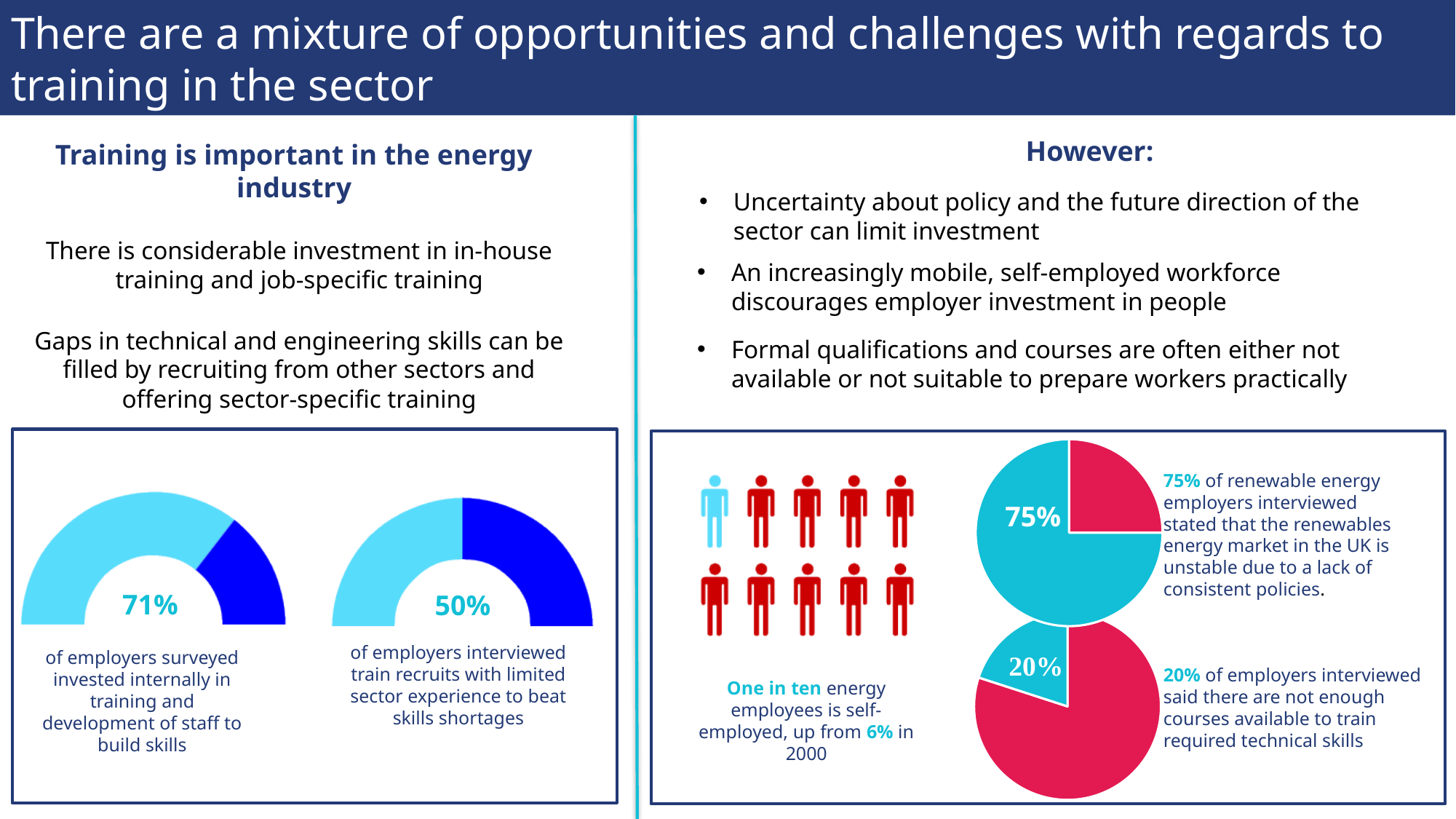
In the upper pie chart on the right of the slide, what share of renewable energy employers interviewed stated that the UK renewables market is unstable due to a lack of consistent policies? 75% According to the pictogram text in the bottom-right panel, what was the share of self-employed energy employees in 2000? 6% How many person icons are shown in the pictogram in the bottom-right panel? 10 On the right-hand gauge chart in the bottom-left panel, what percentage of employers interviewed train recruits with limited sector experience to beat skills shortages? 50% In the lower pie chart on the right of the slide, what percentage of employers interviewed said there are not enough courses are available to train required technical skills? 20% According to the pictogram in the bottom-right panel, what proportion of energy employees is self-employed? One in ten What is the difference between the 71% and 50% values shown on the two gauge charts in the bottom-left panel? 21 percentage points What is the difference between the 75% shown in the upper pie chart and the 20% shown in the lower pie chart on the right of the slide? 55 percentage points Which of the two gauge charts in the bottom-left panel shows the larger value: the one about investing internally in training or the one about training recruits with limited sector experience? Investing internally in training (71%) What type of chart is used to show the 75% and 20% figures on the right of the slide? Pie chart Is the value shown on the left-hand gauge chart in the bottom-left panel greater or less than 70%? greater On the left-hand gauge chart in the bottom-left panel, what percentage of employers surveyed invested internally in training and development of staff to build skills? 71%